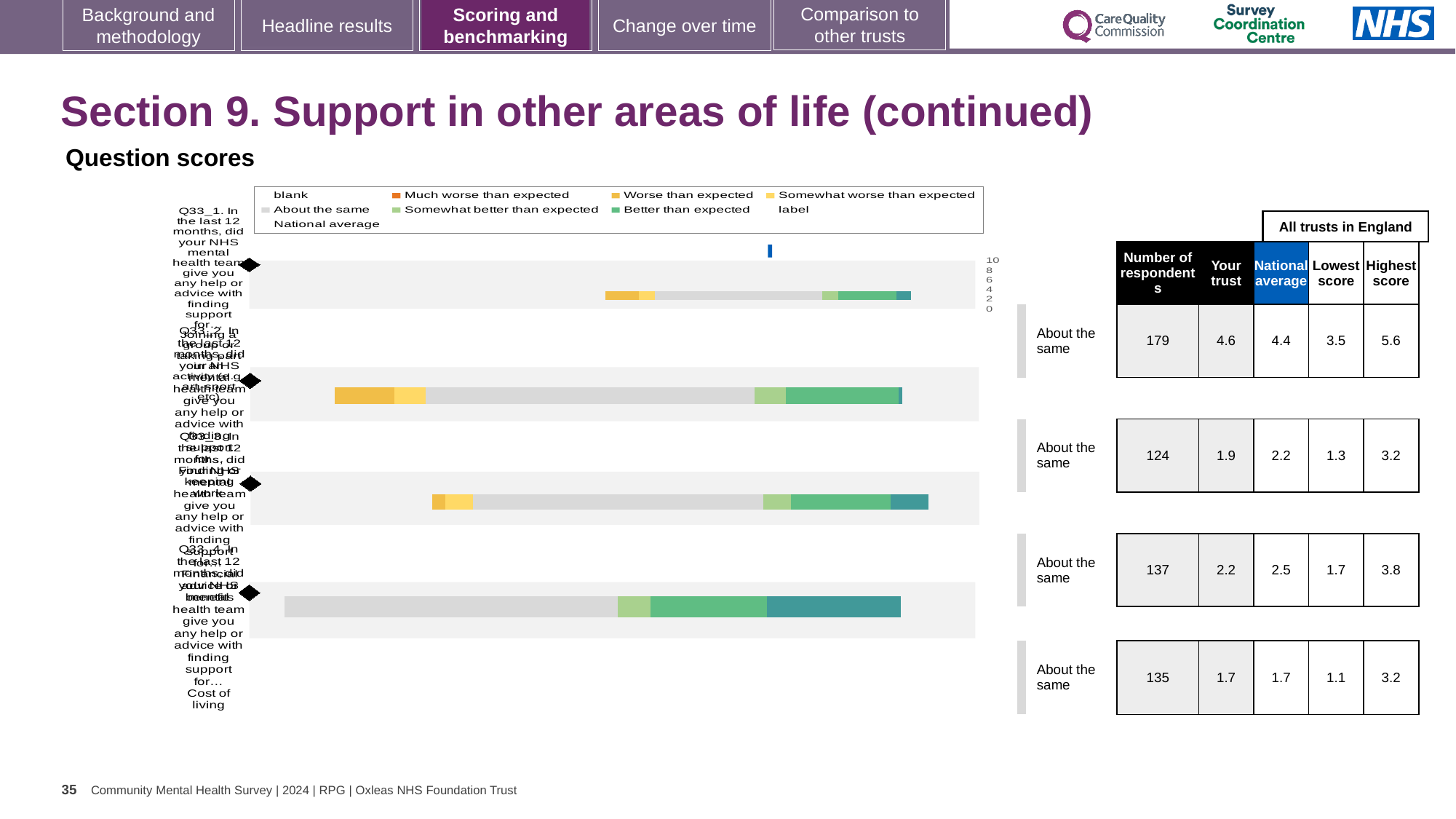
In the table beside the chart, what is the number of respondents for the first question (Q33_1)? 179 In the table beside the chart, which question row has the highest 'Your trust' score? The first row (Q33_1), 4.6 What benchmark category is shown next to every one of the four question bars? About the same What kind of chart is shown under 'Question scores'? bar chart How many question bars are plotted in the chart? 4 In the table beside the chart, what is the difference between the national average and the 'Your trust' score for the second question (Q33_2)? 0.3 In the table beside the chart, what is the highest score among all trusts in England for the third question (Q33_3)? 3.8 In the table beside the chart, for the second question (Q33_2), which is larger: the 'Your trust' score or the national average? National average In the table beside the chart, what is the lowest score among all trusts in England for the fourth question (Q33_4)? 1.1 How many entries does the chart legend list? 9 In the table beside the chart, what is the 'Your trust' score for the first question (Q33_1)? 4.6